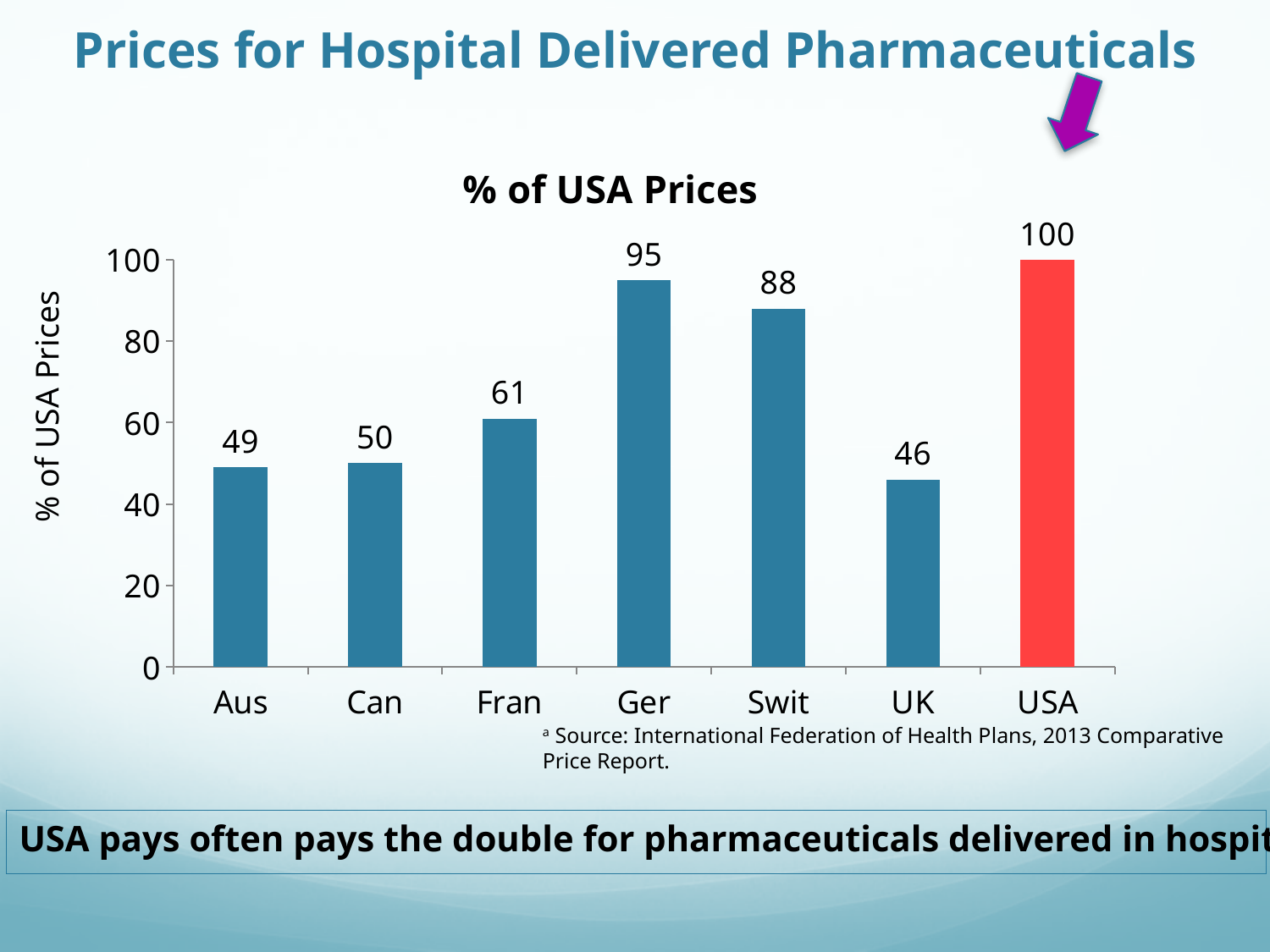
What is the title of the chart? % of USA Prices Which country has the highest value? USA What is the difference between the values for Ger and Swit? 7 What is the value for Ger? 95 Which country has the lowest value? UK Is the value for Swit greater or less than 80? greater What is the value for UK? 46 How many countries are shown on the x axis? 7 What kind of chart is shown? bar chart Which is larger, the value for Fran or the value for Can? Fran What is the difference between the values for USA and Aus? 51 What is the value for Fran? 61